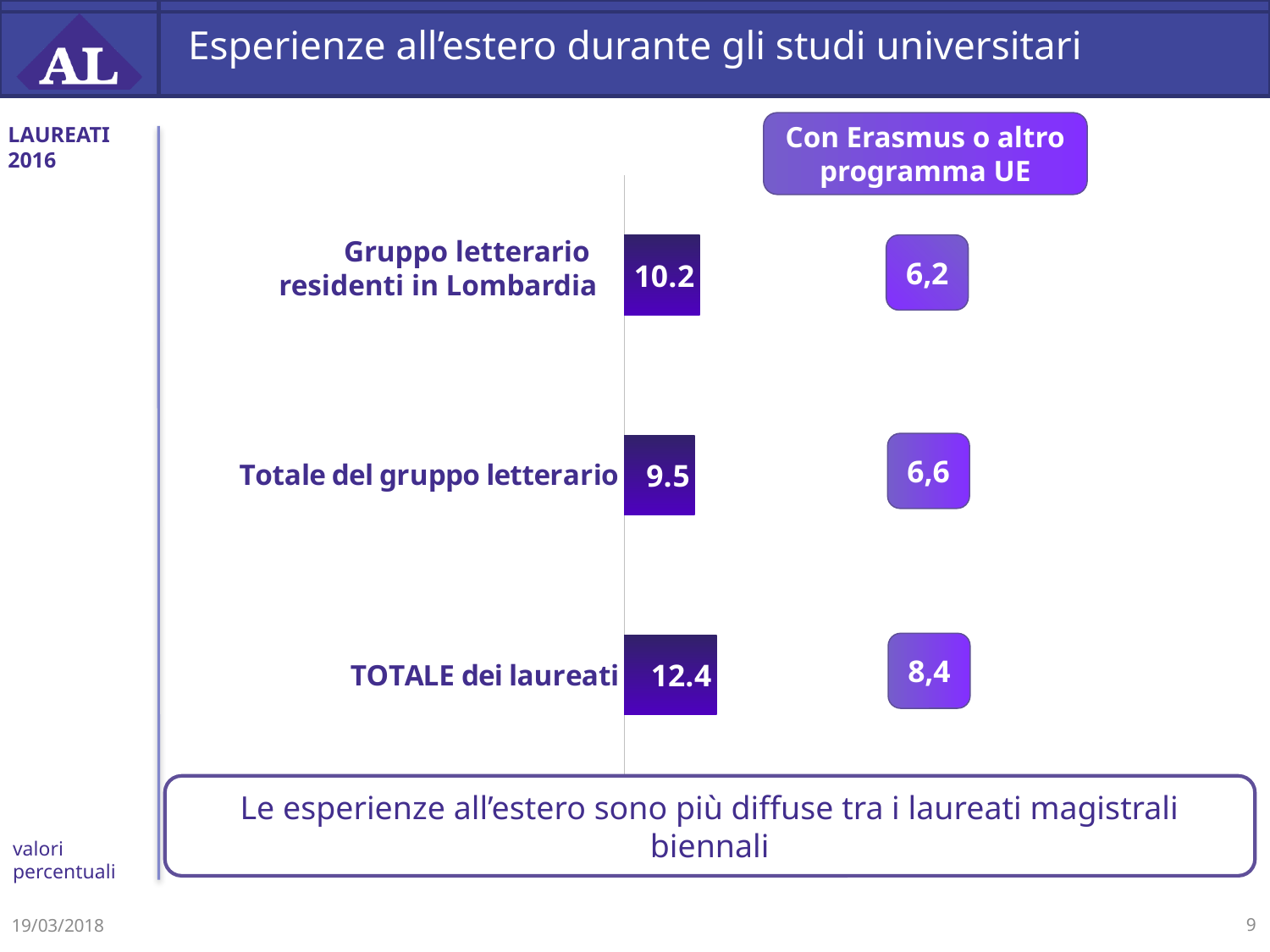
Which category has the highest bar value? TOTALE dei laureati What is the title of the slide containing the chart? Esperienze all'estero durante gli studi universitari What is the difference between the bar values for TOTALE dei laureati and Totale del gruppo letterario? 2.9 What is the difference between the bar values for Gruppo letterario residenti in Lombardia and Totale del gruppo letterario? 0.7 What is the value shown in the 'Con Erasmus o altro programma UE' box for TOTALE dei laureati? 8,4 What is the value of the bar for TOTALE dei laureati? 12.4 What is the value of the bar for Totale del gruppo letterario? 9.5 What is the value of the bar for Gruppo letterario residenti in Lombardia? 10.2 Which category has the lowest bar value? Totale del gruppo letterario What kind of chart is shown on the slide? Bar chart How many categories are shown in the bar chart? 3 Which has a larger bar value, Gruppo letterario residenti in Lombardia or TOTALE dei laureati? TOTALE dei laureati